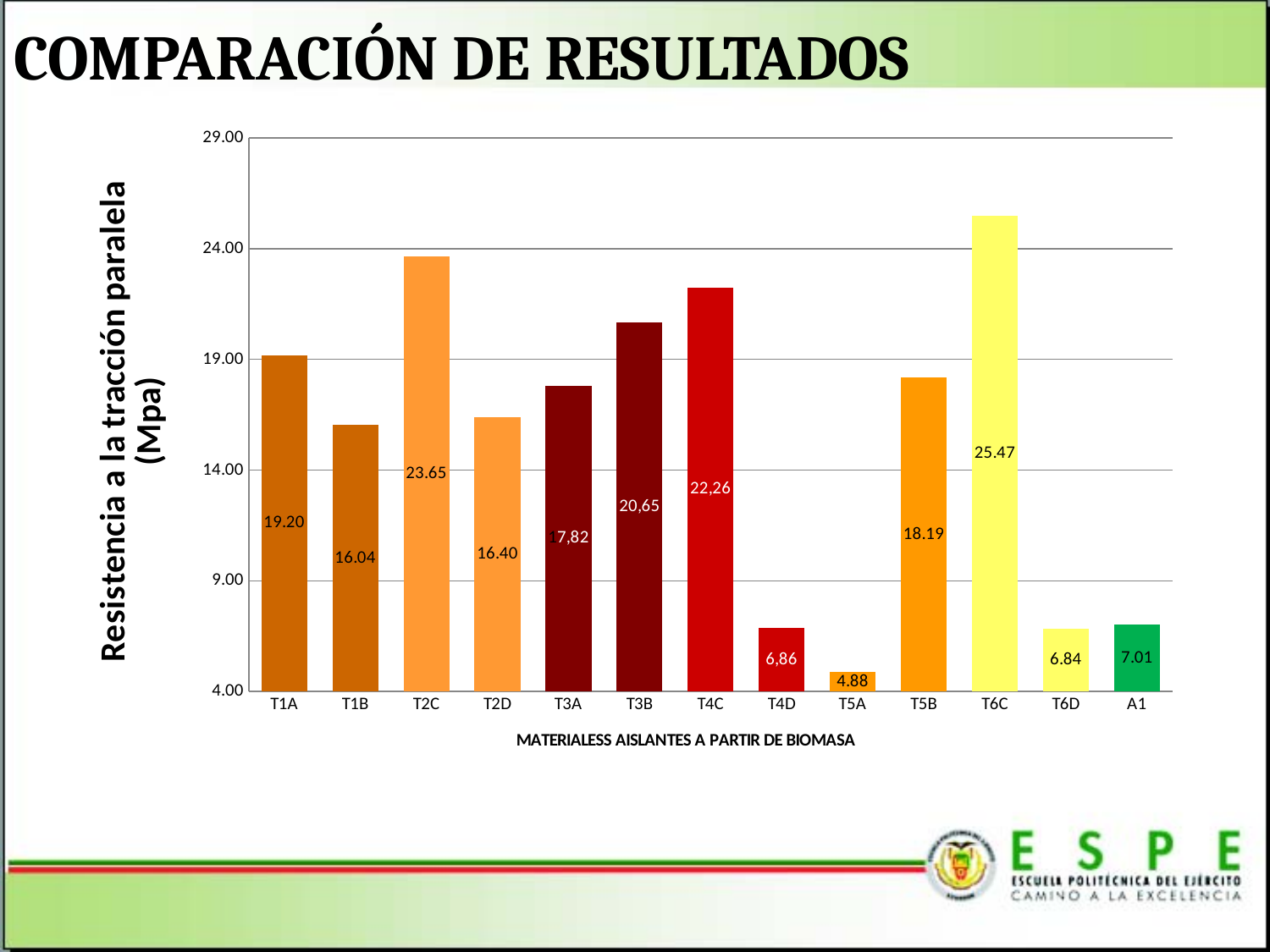
What is the difference between the values for T2C and T1A? 4.45 What is the label of the y axis? Resistencia a la tracción paralela (Mpa) Which category has the highest value? T6C What is the value for T1A? 19.20 What is the value for A1? 7.01 What kind of chart is shown on the slide? Bar chart What is the value for T4C? 22,26 Which is larger, the value for T4C or the value for T3B? T4C What is the difference between the values for T6C and T5A? 20.59 How many categories are shown on the x axis? 13 What is the value for T6C? 25.47 Which category has the lowest value? T5A